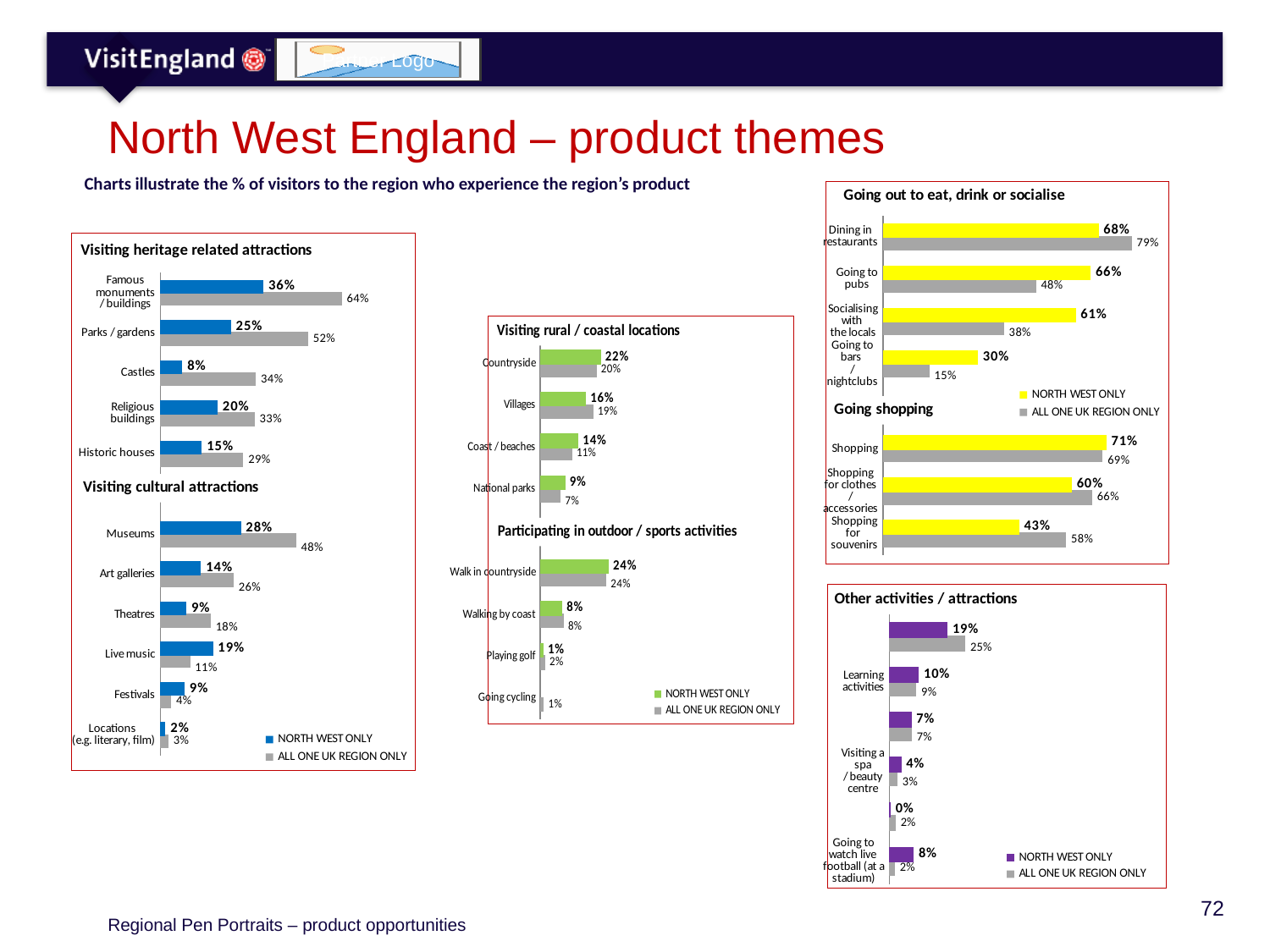
In the 'Visiting cultural attractions' chart, which is larger for Live music: the NORTH WEST ONLY value or the ALL ONE UK REGION ONLY value? NORTH WEST ONLY In the 'Visiting heritage related attractions' chart, which category has the highest NORTH WEST ONLY value? Famous monuments / buildings In the 'Going out to eat, drink or socialise' chart, what is the NORTH WEST ONLY value for Going to pubs? 66% In the 'Participating in outdoor / sports activities' chart, what is the ALL ONE UK REGION ONLY value for Playing golf? 2% In the 'Going out to eat, drink or socialise' chart, which category has the lowest ALL ONE UK REGION ONLY value? Going to bars / nightclubs In the 'Visiting heritage related attractions' chart, what is the difference between the ALL ONE UK REGION ONLY and NORTH WEST ONLY values for Parks / gardens? 27% In the 'Visiting cultural attractions' chart, how many categories are shown? 6 In the 'Visiting heritage related attractions' chart, what is the NORTH WEST ONLY value for Castles? 8% In the 'Going shopping' chart, what is the difference between the ALL ONE UK REGION ONLY and NORTH WEST ONLY values for Shopping for souvenirs? 15% In the 'Visiting rural / coastal locations' chart, what is the NORTH WEST ONLY value for Villages? 16% In the 'Visiting cultural attractions' chart, what is the ALL ONE UK REGION ONLY value for Museums? 48% How many series does the legend list in the 'Other activities / attractions' chart? 2